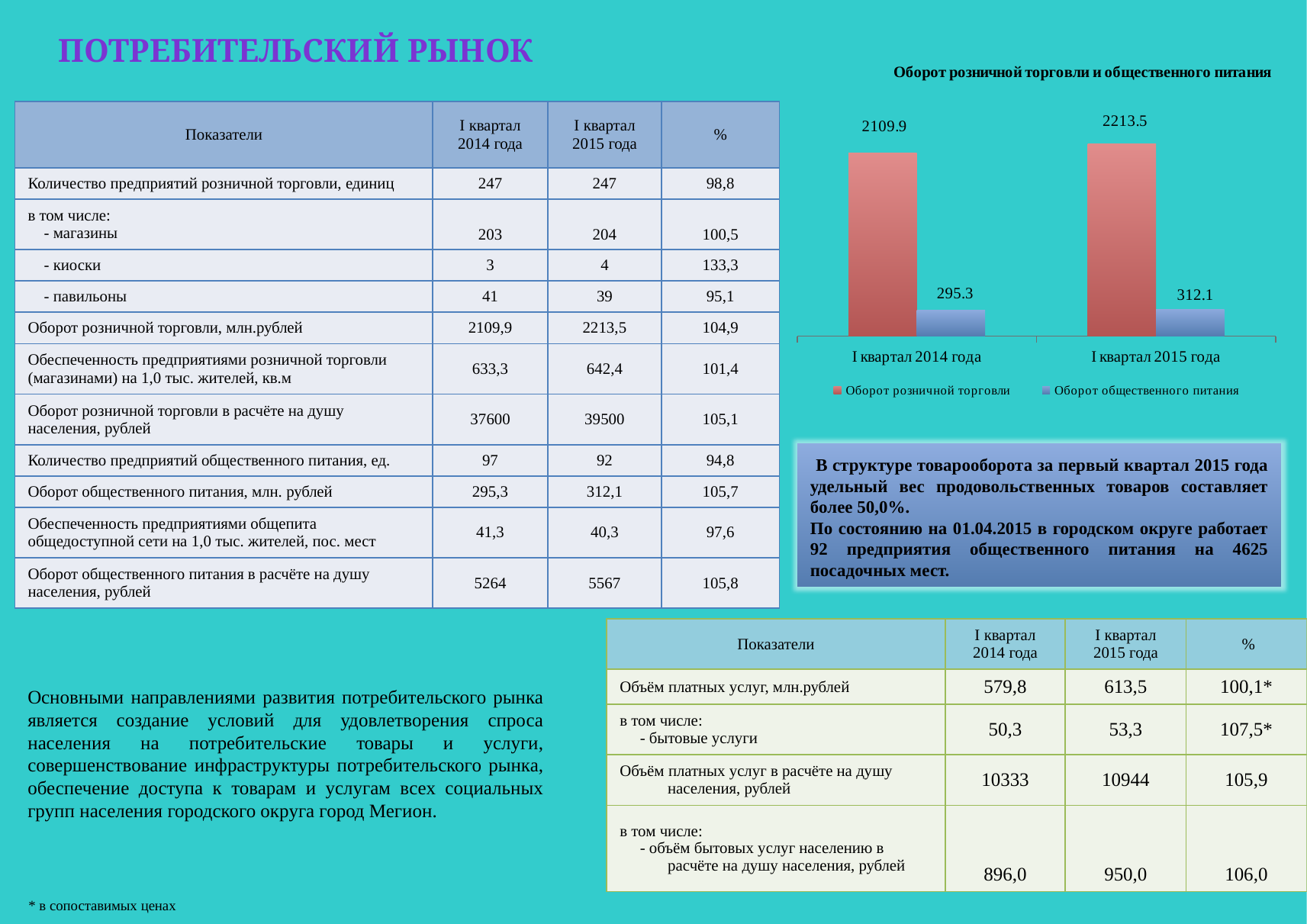
Which category has the higher value for Оборот розничной торговли? I квартал 2015 года What is the title of the chart? Оборот розничной торговли и общественного питания What type of chart is shown on the slide? bar chart What is the difference between Оборот розничной торговли in I квартал 2015 года and I квартал 2014 года? 103.6 Does Оборот общественного питания rise or fall from I квартал 2014 года to I квартал 2015 года? rise Which category has the lower value for Оборот общественного питания? I квартал 2014 года What is the value of Оборот общественного питания for I квартал 2015 года? 312.1 What is the value of Оборот розничной торговли for I квартал 2015 года? 2213.5 How many series does the chart legend list? 2 What is the value of Оборот розничной торговли for I квартал 2014 года? 2109.9 How many categories are shown on the x axis of the chart? 2 What is the value of Оборот общественного питания for I квартал 2014 года? 295.3